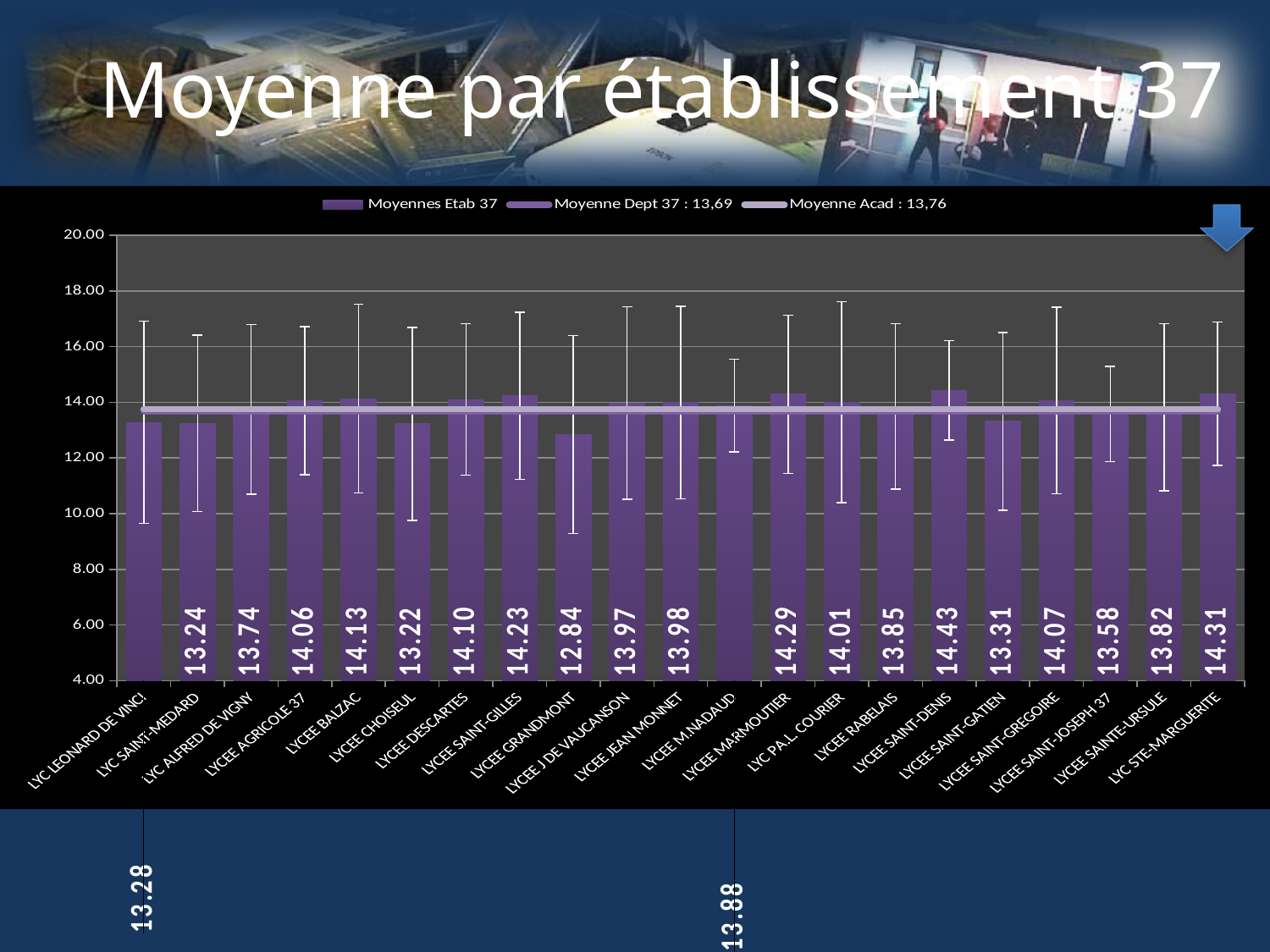
According to the legend, what is the value of Moyenne Dept 37? 13,69 What is the value shown for LYCEE BALZAC? 14.13 How many establishments (bars) are plotted on the chart? 21 What kind of chart is shown on the slide? Combination bar and line chart Which establishment has the highest value on the chart? LYCEE SAINT-DENIS Is the value for LYCEE CHOISEUL greater or less than 14.00? less What is the difference between the values for LYCEE SAINT-DENIS and LYCEE GRANDMONT? 1.59 How many entries does the chart legend list? 3 Which has the larger value, LYCEE MARMOUTIER or LYCEE RABELAIS? LYCEE MARMOUTIER Which establishment has the lowest value on the chart? LYCEE GRANDMONT What is the value shown for LYCEE GRANDMONT? 12.84 What is the value shown for LYCEE SAINT-GILLES? 14.23